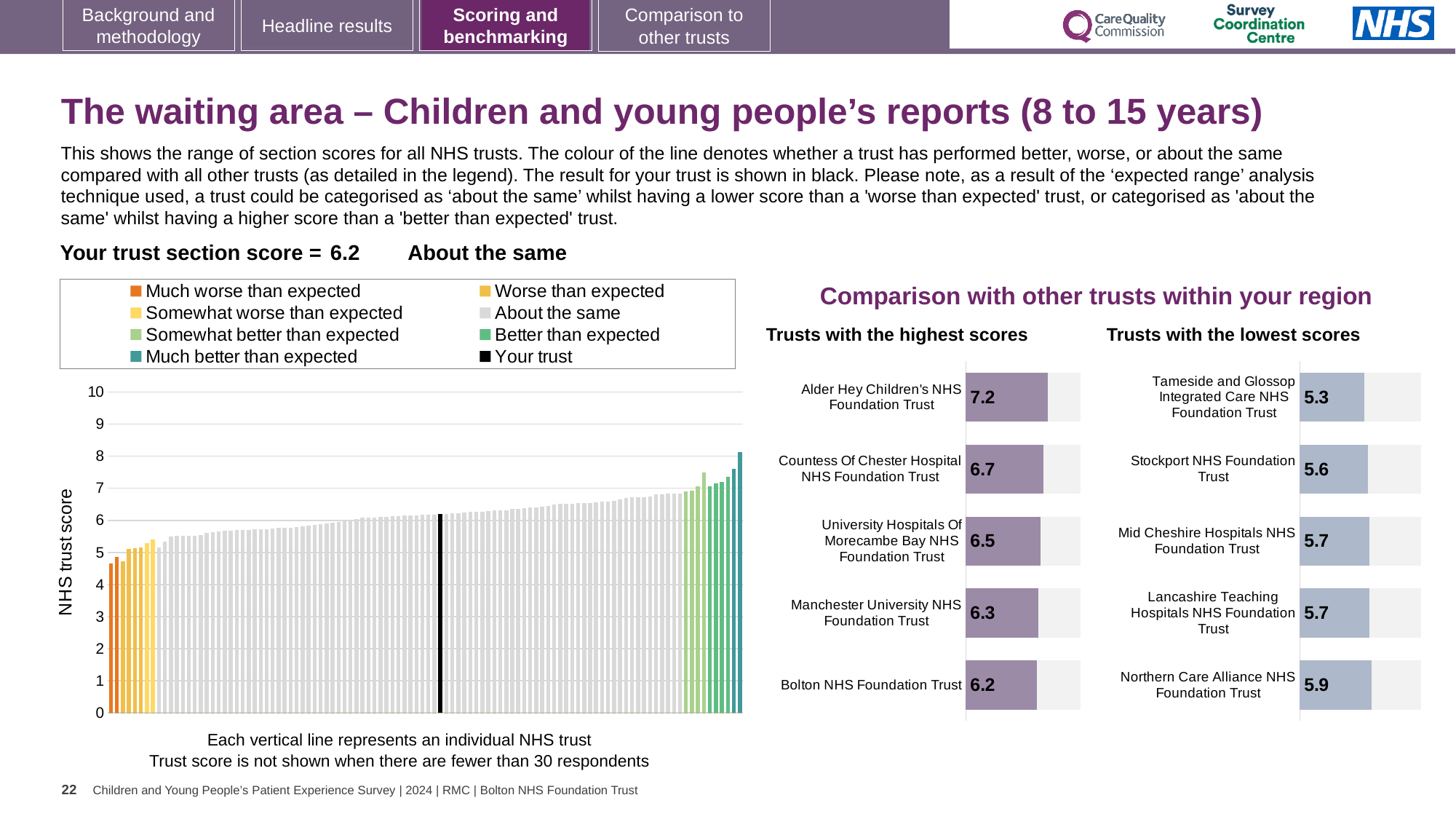
In the NHS trust score chart on the left, do the bar values rise or fall from left to right? rise In the 'Trusts with the highest scores' chart, which trust has the highest score? Alder Hey Children's NHS Foundation Trust In the 'Trusts with the lowest scores' chart, what is the difference between the scores of Northern Care Alliance NHS Foundation Trust and Tameside and Glossop Integrated Care NHS Foundation Trust? 0.6 In the 'Trusts with the lowest scores' chart, which trust has the lowest score? Tameside and Glossop Integrated Care NHS Foundation Trust How many trusts are shown in the 'Trusts with the highest scores' chart? 5 How many entries does the legend of the NHS trust score chart on the left list? 8 In the 'Trusts with the lowest scores' chart, which has the higher score: Stockport NHS Foundation Trust or Northern Care Alliance NHS Foundation Trust? Northern Care Alliance NHS Foundation Trust In the 'Trusts with the highest scores' chart, what is the score for Alder Hey Children's NHS Foundation Trust? 7.2 In the NHS trust score chart on the left, is the value of the lowest (leftmost) bar greater or less than 5? less In the 'Trusts with the highest scores' chart, what is the score for Manchester University NHS Foundation Trust? 6.3 In the 'Trusts with the highest scores' chart, what is the difference between the scores of Alder Hey Children's NHS Foundation Trust and Bolton NHS Foundation Trust? 1.0 In the 'Trusts with the lowest scores' chart, what is the score for Stockport NHS Foundation Trust? 5.6